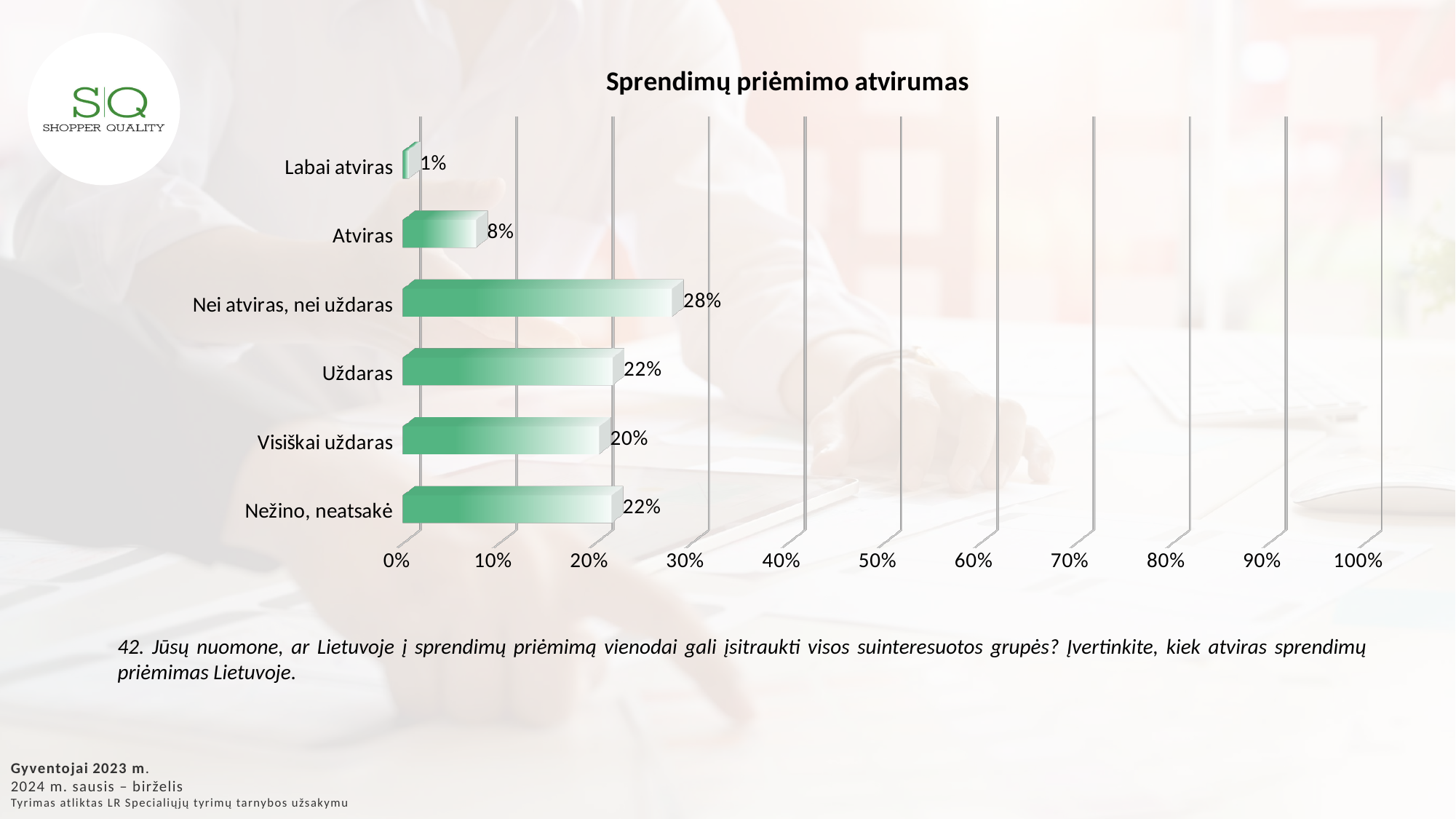
What is the value for "Labai atviras"? 1% How many categories are shown in the chart? 6 What is the title of the chart? Sprendimų priėmimo atvirumas What is the value for "Atviras"? 8% Which category has the highest value? Nei atviras, nei uždaras What is the value for "Nei atviras, nei uždaras"? 28% What is the difference between the values for "Atviras" and "Labai atviras"? 7% What kind of chart is shown on the slide? Bar chart Which category has the lowest value? Labai atviras What is the difference between the values for "Nei atviras, nei uždaras" and "Uždaras"? 6% Which is larger, the value for "Uždaras" or the value for "Visiškai uždaras"? Uždaras What is the value for "Visiškai uždaras"? 20%